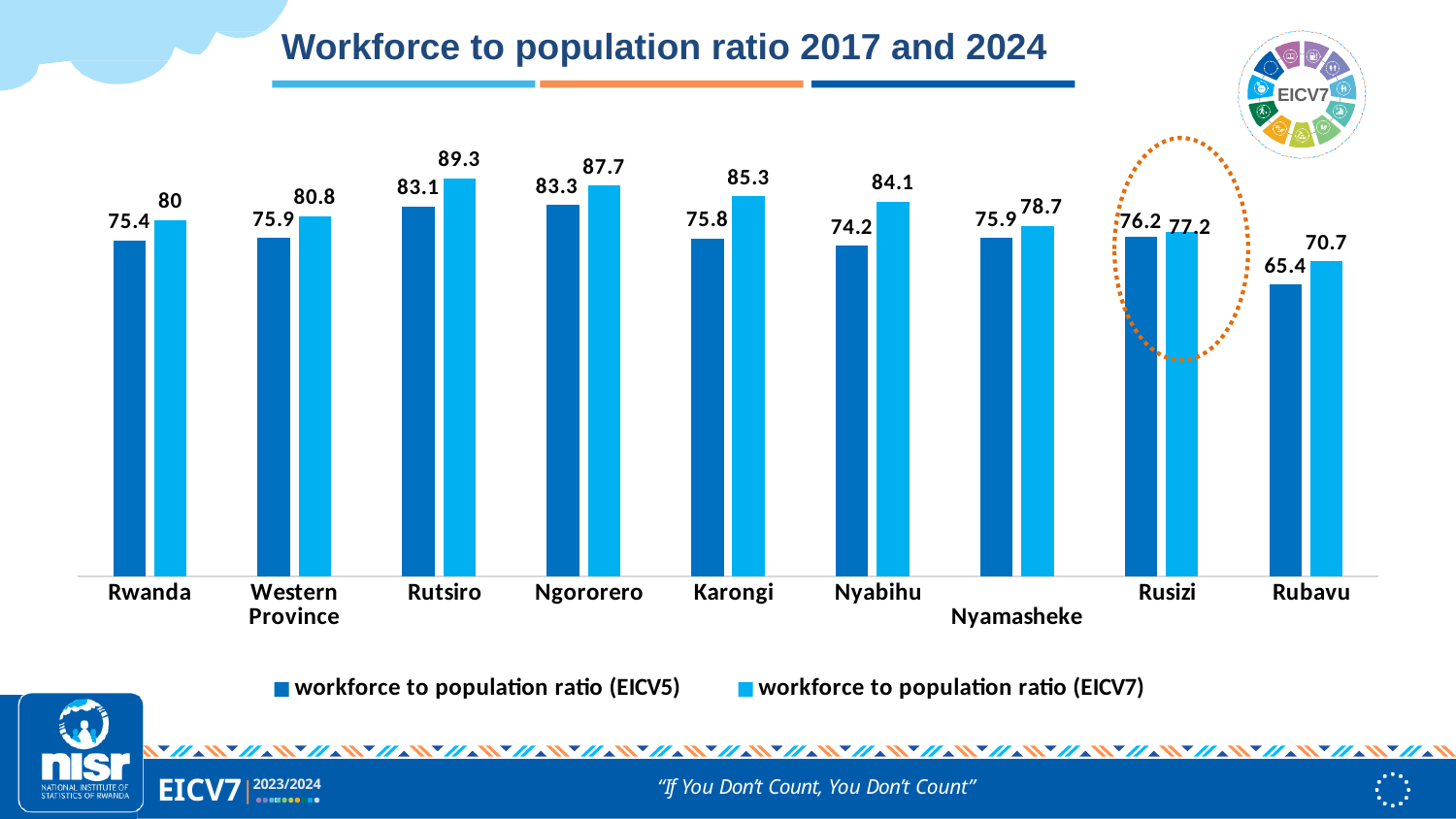
Which is larger: the EICV7 workforce to population ratio for Ngororero or for Nyabihu? Ngororero What kind of chart is shown on the slide? Bar chart How many series does the legend list? 2 What is the title of the chart? Workforce to population ratio 2017 and 2024 Which category has the lowest workforce to population ratio (EICV5)? Rubavu Which category has the highest workforce to population ratio (EICV7)? Rutsiro What is the workforce to population ratio (EICV5) for Nyabihu? 74.2 What is the workforce to population ratio (EICV7) for Rutsiro? 89.3 What is the workforce to population ratio (EICV7) for Rubavu? 70.7 What is the difference between the EICV7 and EICV5 workforce to population ratios for Karongi? 9.5 What is the difference between the EICV7 and EICV5 workforce to population ratios for Rusizi? 1 How many categories are shown on the x axis of the chart? 9